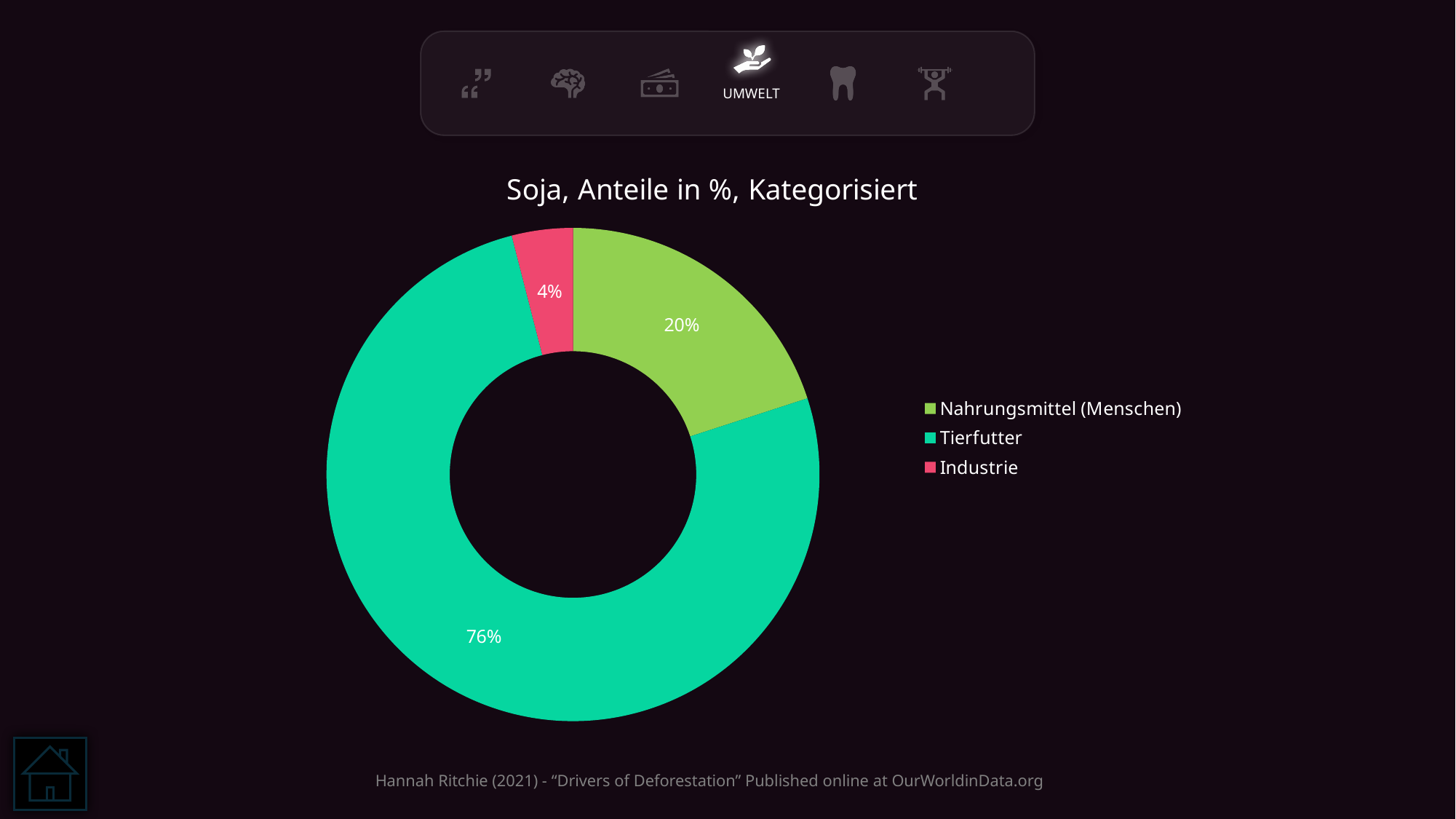
Which category has the largest share? Tierfutter Which is larger, the share of Nahrungsmittel (Menschen) or the share of Industrie? Nahrungsmittel (Menschen) Which category is shown in pink/red in the legend? Industrie What kind of chart is shown on the slide? Doughnut chart What share of the pie does Industrie have? 4% What share of the pie does Nahrungsmittel (Menschen) have? 20% What is the difference between the shares of Nahrungsmittel (Menschen) and Industrie? 16% What is the difference between the shares of Tierfutter and Nahrungsmittel (Menschen)? 56% What is the title of the chart? Soja, Anteile in %, Kategorisiert Which category has the smallest share? Industrie What share of the pie does Tierfutter have? 76% How many categories does the pie chart show? 3